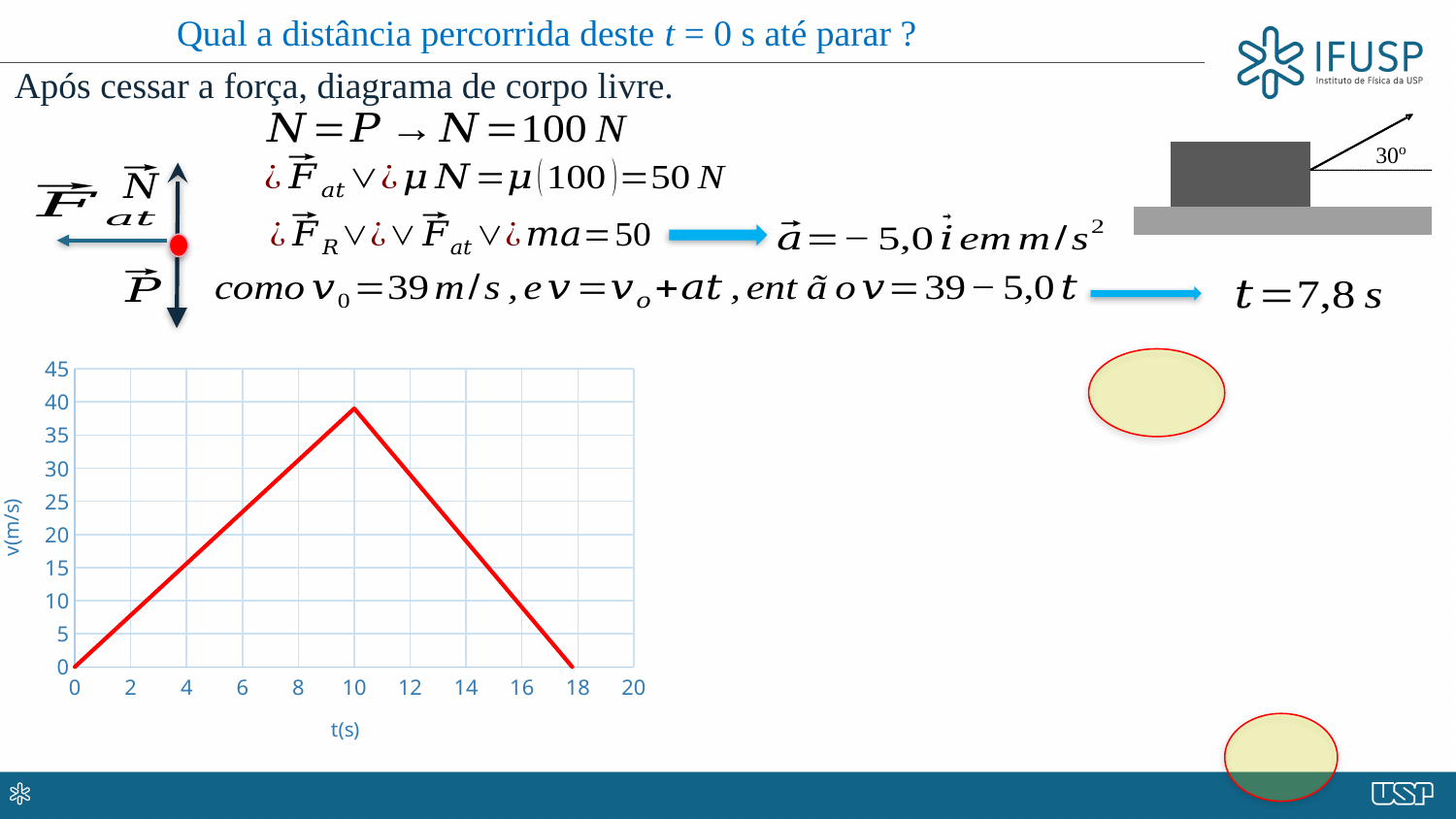
At what value of t(s) does the line reach its highest point? 10 What is the label of the vertical axis of the chart? v(m/s) Is the value of v(m/s) at t = 12 s greater or less than 25? greater Which is larger, the value of v(m/s) at t = 4 s or at t = 8 s? t = 8 s Does the line rise or fall between t = 0 and t = 10? rise Is the value of v(m/s) at t = 6 s greater or less than 25? less What is the label of the horizontal axis of the chart? t(s) What is the value of v(m/s) at t = 0 s? 0 Is the value of v(m/s) at t = 4 s greater or less than 10? greater What kind of chart is shown on the slide? line chart Does the line rise or fall between t = 10 and t = 18? fall